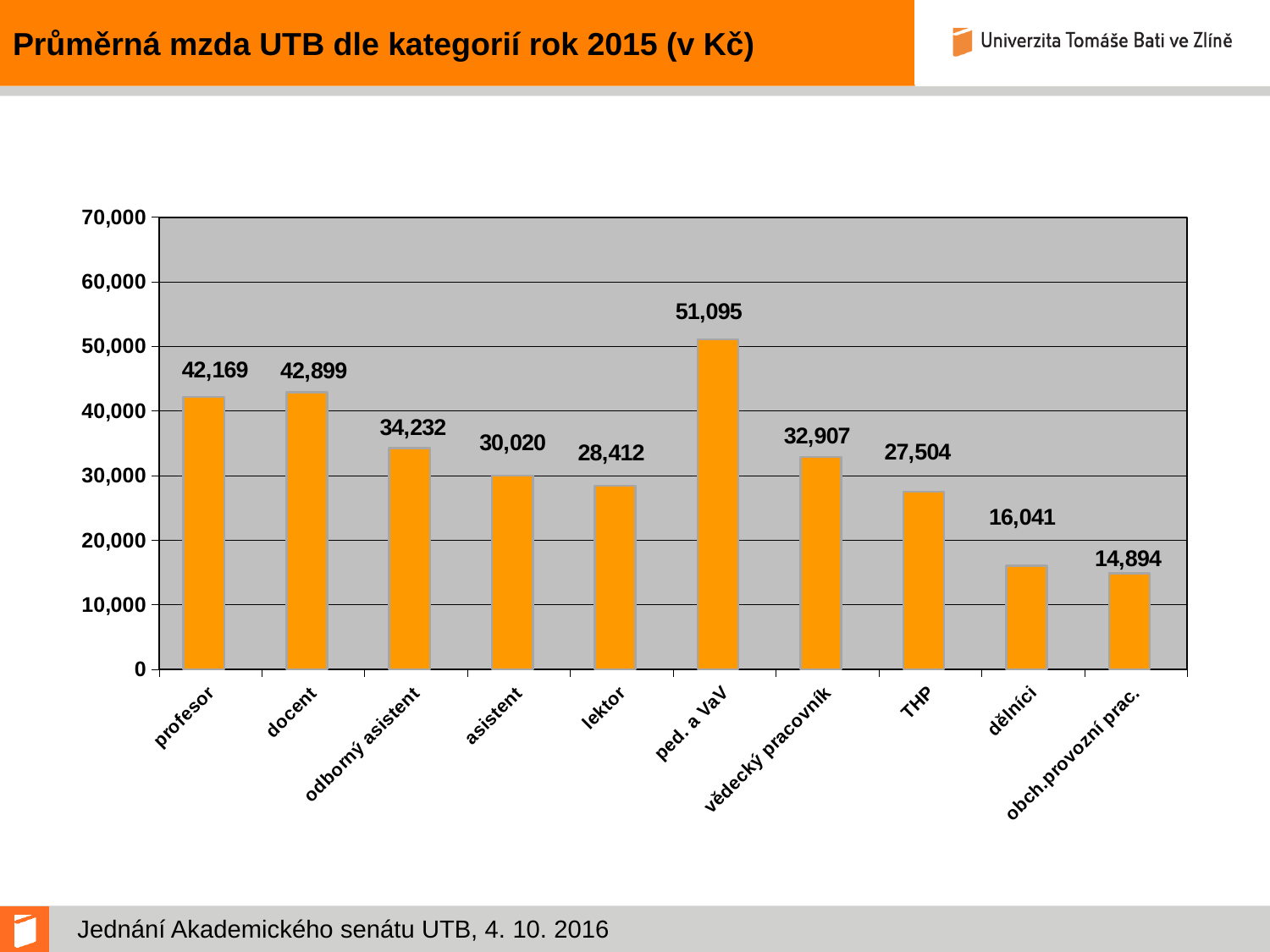
What is the value shown for 'ped. a VaV'? 51,095 Is the value for 'dělníci' greater or less than 20,000? less How many categories are shown on the chart? 10 What is the title of the slide containing the chart? Průměrná mzda UTB dle kategorií rok 2015 (v Kč) Which is larger, the value for 'odborný asistent' or the value for 'vědecký pracovník'? odborný asistent Which category has the lowest average salary? obch.provozní prac. What is the difference between the values for 'docent' and 'profesor'? 730 What is the value shown for 'THP'? 27,504 What is the difference between the values for 'ped. a VaV' and 'vědecký pracovník'? 18,188 Which category has the highest average salary? ped. a VaV What kind of chart is shown on the slide? bar chart What is the average salary for the 'profesor' category? 42,169